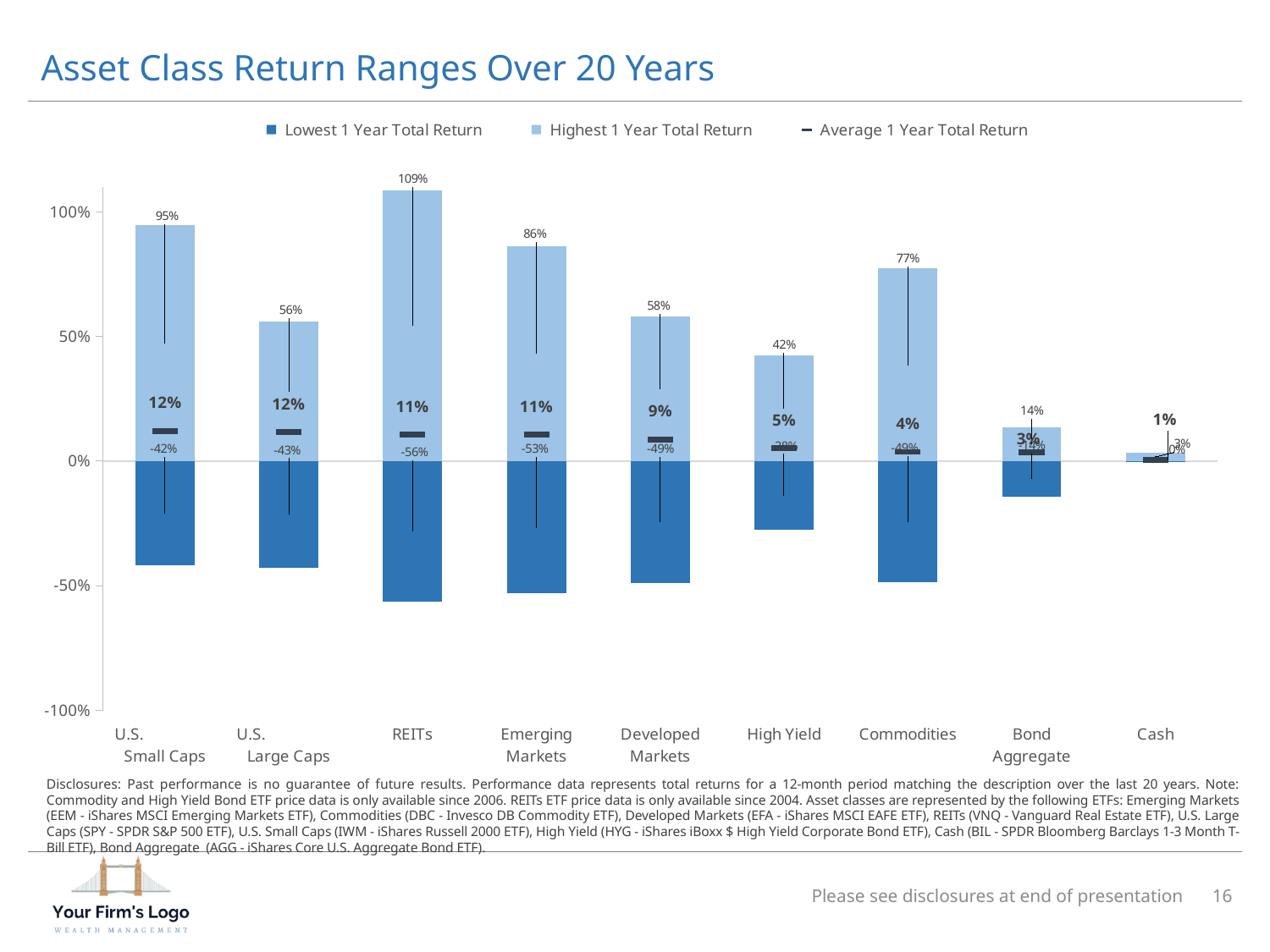
What is the Average 1 Year Total Return for Developed Markets? 9% Which has a larger Highest 1 Year Total Return, Emerging Markets or Commodities? Emerging Markets What is the Highest 1 Year Total Return for REITs? 109% What is the Lowest 1 Year Total Return for REITs? -56% What is the Average 1 Year Total Return for Commodities? 4% Which asset class has the lowest Highest 1 Year Total Return? Cash Is the Highest 1 Year Total Return for High Yield greater or less than 50%? less How many asset classes are shown on the x axis? 9 How many series does the legend list? 3 Which asset class has the highest Highest 1 Year Total Return? REITs What is the Lowest 1 Year Total Return for U.S. Small Caps? -42% What is the difference between the Highest 1 Year Total Return for U.S. Small Caps and U.S. Large Caps? 39 percentage points